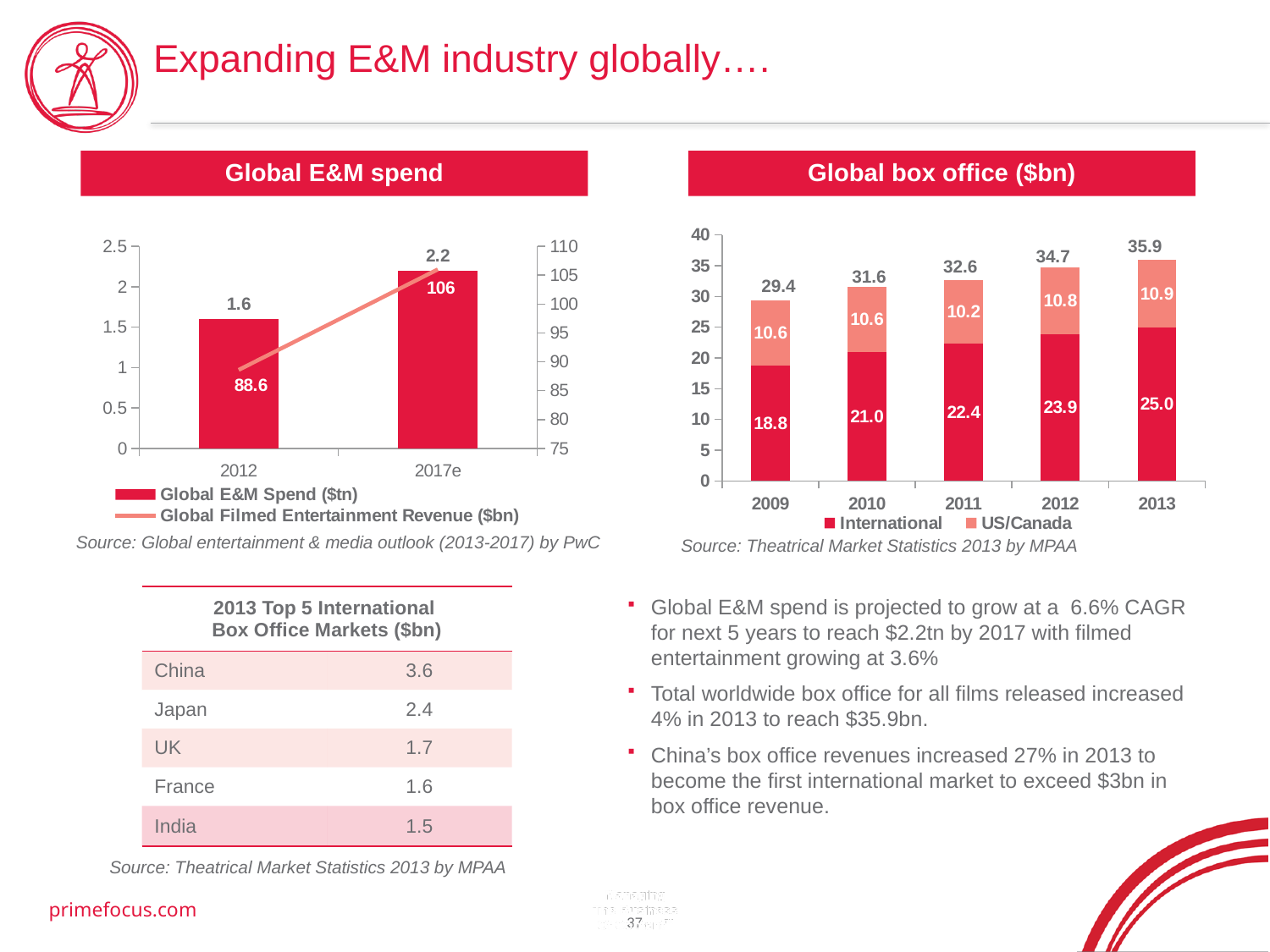
In the Global box office ($bn) chart, how many years are shown on the x axis? 5 In the Global box office ($bn) chart, what is the International value for 2011? 22.4 In the Global E&M spend chart, what is the difference between the Global Filmed Entertainment Revenue values for 2017e and 2012? 17.4 In the Global E&M spend chart, how many series does the legend list? 2 In the Global E&M spend chart, does the Global Filmed Entertainment Revenue line rise or fall from 2012 to 2017e? rise In the Global box office ($bn) chart, what is the US/Canada value for 2012? 10.8 What kind of chart is the Global box office ($bn) chart? stacked bar chart In the Global box office ($bn) chart, what is the difference between the International values for 2013 and 2009? 6.2 In the Global box office ($bn) chart, what is the total of the stacked bar for 2013? 35.9 In the Global box office ($bn) chart, which year has the lowest total box office? 2009 In the Global E&M spend chart, what is the Global Filmed Entertainment Revenue ($bn) value for 2012? 88.6 In the Global E&M spend chart, what is the Global E&M Spend ($tn) value for 2017e? 2.2